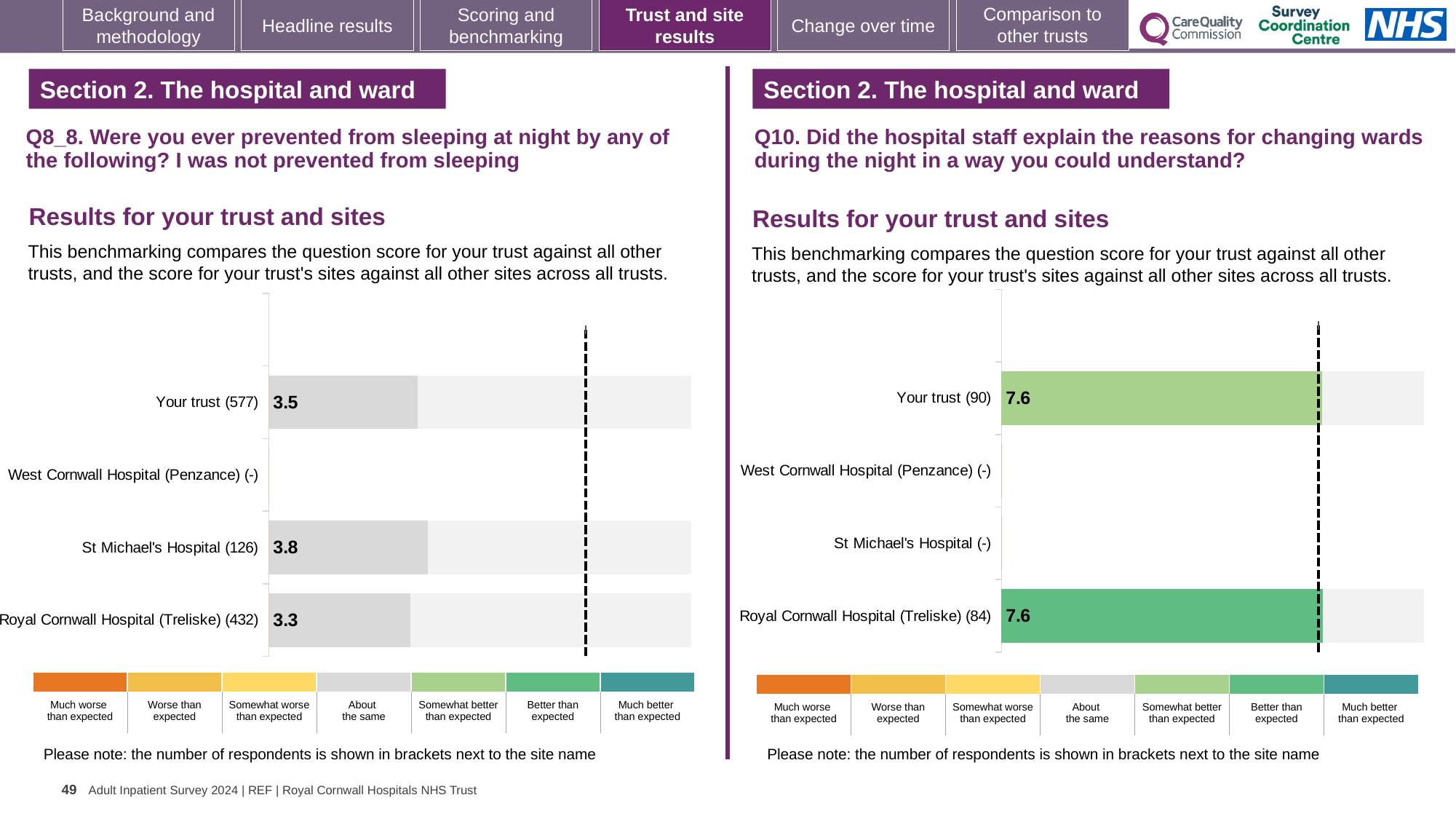
On the Q8_8 chart (left), which is larger: the score for Your trust or the score for Royal Cornwall Hospital (Treliske)? Your trust On the Q8_8 chart (left), what is the score for St Michael's Hospital? 3.8 On the Q8_8 chart (left), what is the score for Your trust? 3.5 On the Q8_8 chart (left), how many respondents are shown in brackets for Your trust? 577 On the Q8_8 chart (left), which site has the highest score? St Michael's Hospital On the Q10 chart (right), what is the score for Royal Cornwall Hospital (Treliske)? 7.6 On the Q10 chart (right), what is the score for Your trust? 7.6 On the Q8_8 chart (left), what is the score for Royal Cornwall Hospital (Treliske)? 3.3 On the Q8_8 chart (left), what is the difference between the scores for St Michael's Hospital and Royal Cornwall Hospital (Treliske)? 0.5 What kind of chart is used on the Q10 chart (right)? Bar chart On the Q10 chart (right), how many respondents are shown in brackets for Royal Cornwall Hospital (Treliske)? 84 On the Q8_8 chart (left), how many site rows (including Your trust) are listed on the vertical axis? 4